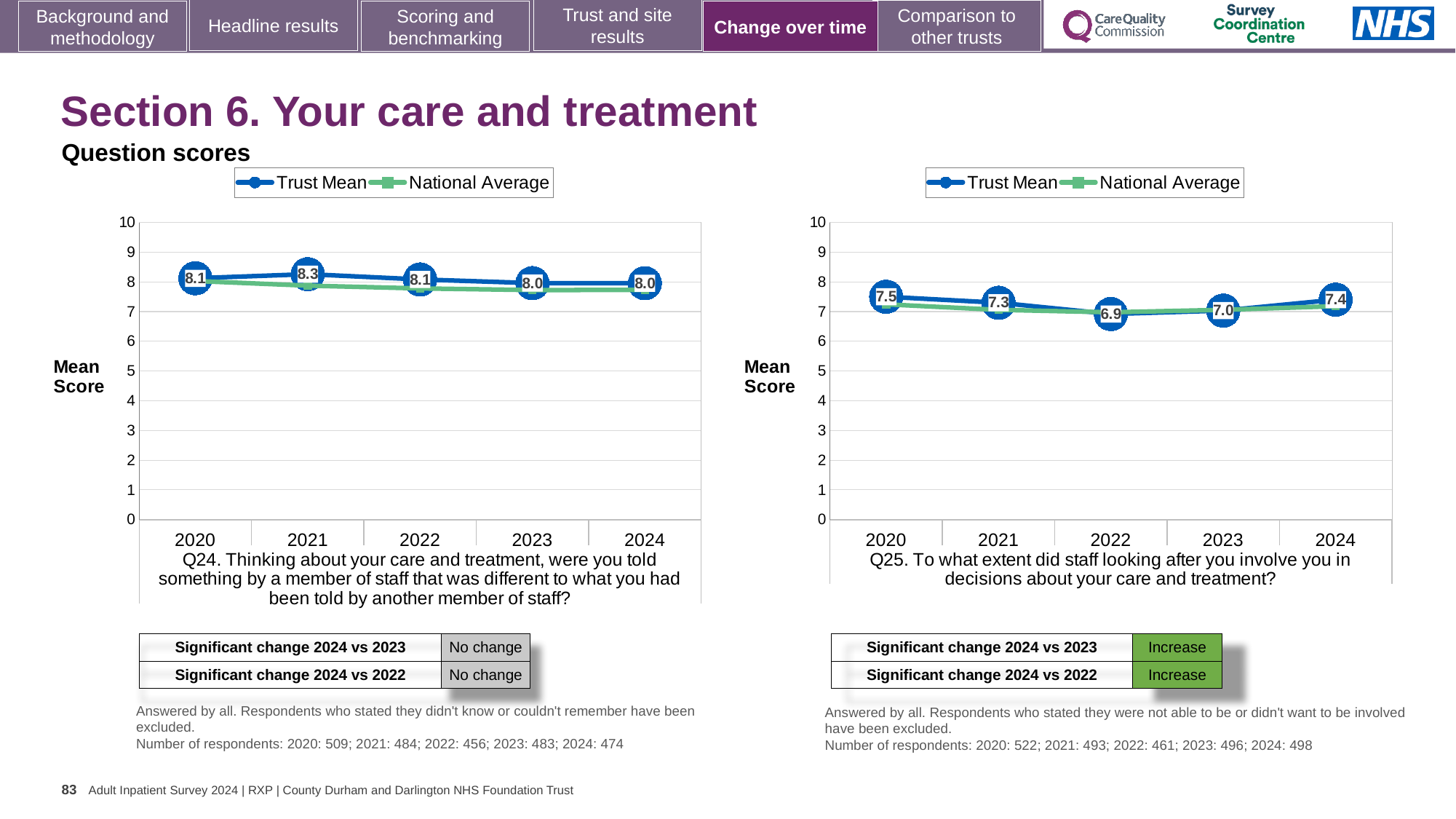
On the left chart (Q24), which year has the highest Trust Mean score? 2021 On the right chart (Q25), is the National Average value for 2020 greater or less than 6? greater On the left chart (Q24), what is the Trust Mean score for 2024? 8.0 On the left chart (Q24), is the Trust Mean score for 2020 larger or smaller than the Trust Mean score for 2021? smaller What type of chart is used for Q25 on the right of the slide? Line chart On the right chart (Q25), what is the Trust Mean score for 2022? 6.9 How many years are plotted on the x axis of the left chart (Q24)? 5 On the left chart (Q24), what is the Trust Mean score for 2021? 8.3 How many series does the legend of the right chart (Q25) list? 2 On the right chart (Q25), what is the Trust Mean score for 2024? 7.4 On the right chart (Q25), what is the difference between the Trust Mean scores for 2024 and 2022? 0.5 On the right chart (Q25), which year has the lowest Trust Mean score? 2022